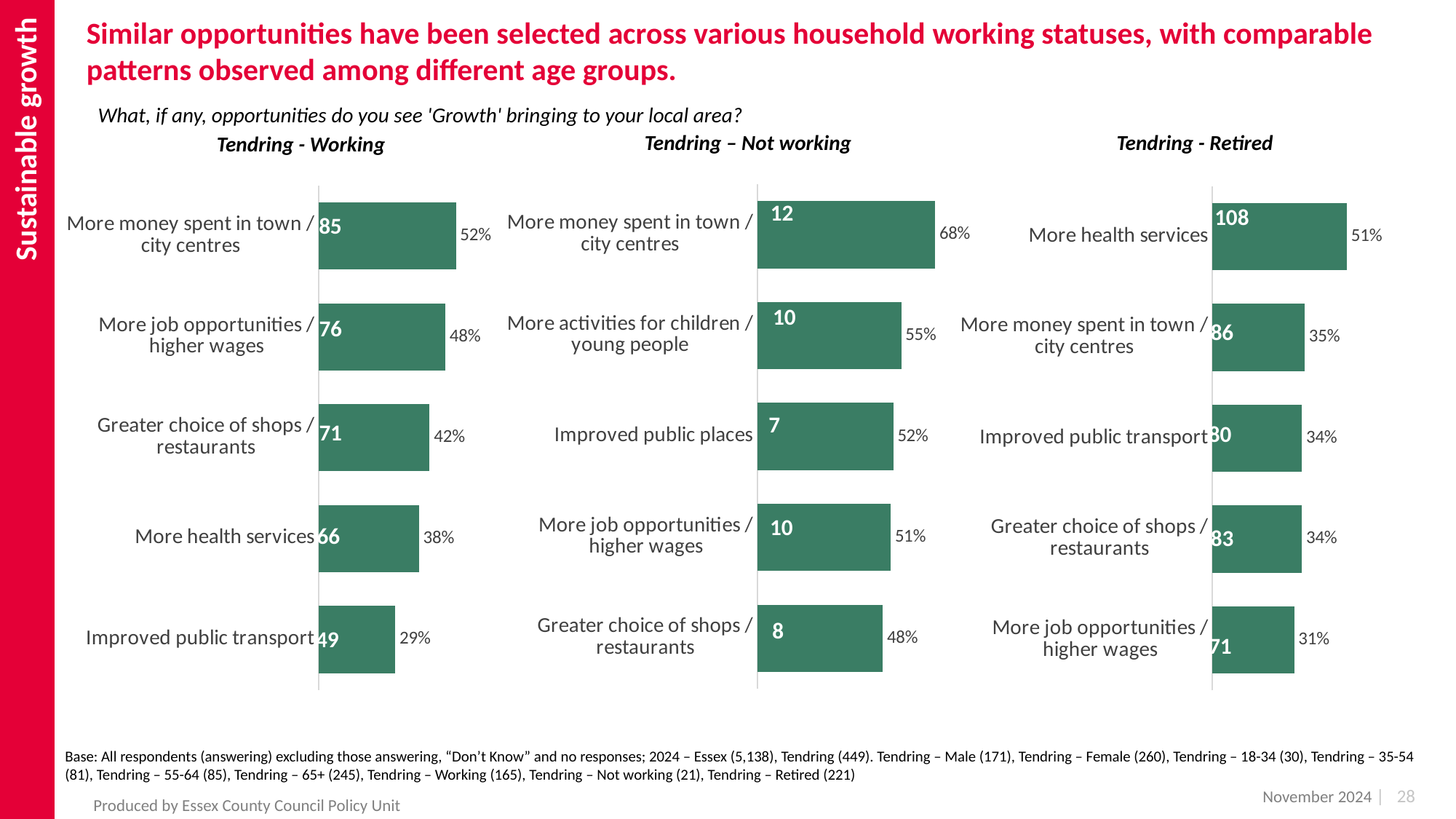
In the 'Tendring - Working' chart, what percentage is shown for 'More money spent in town / city centres'? 52% In the 'Tendring – Not working' chart, what percentage is shown for 'More activities for children / young people'? 55% In the 'Tendring - Retired' chart, what count is shown for 'More health services'? 108 What type of chart is used for 'Tendring - Working'? Bar chart In the 'Tendring – Not working' chart, which category has the lowest percentage? Greater choice of shops / restaurants What survey question is shown above the three charts? What, if any, opportunities do you see 'Growth' bringing to your local area? In the 'Tendring - Retired' chart, which has a higher percentage: 'More money spent in town / city centres' or 'More job opportunities / higher wages'? More money spent in town / city centres In the 'Tendring - Retired' chart, which category has the highest percentage? More health services How many categories are shown in the 'Tendring – Not working' chart? 5 In the 'Tendring - Working' chart, what count is shown for 'Improved public transport'? 49 In the 'Tendring - Working' chart, what is the difference in counts between 'More money spent in town / city centres' and 'Improved public transport'? 36 In the 'Tendring - Retired' chart, what percentage is shown for 'Improved public transport'? 34%